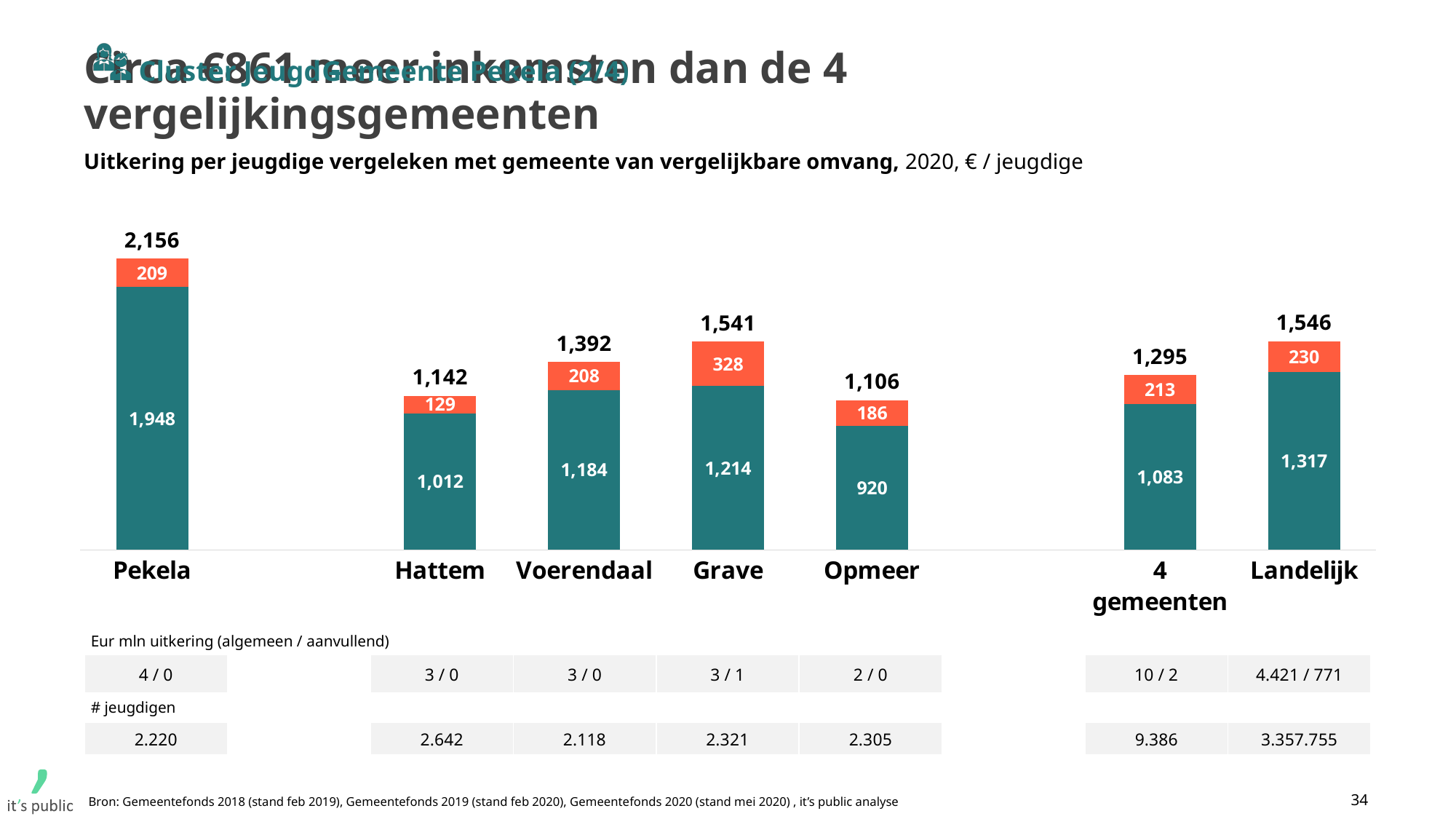
What is the total value printed above the bar for Landelijk? 1,546 Which category has the smallest orange (upper) segment? Hattem Which category has the highest total value? Pekela What is the value of the teal (lower) segment for Opmeer? 920 What is the difference between the printed totals for Pekela and 4 gemeenten? 861 What is the value of the teal (lower) segment for Hattem? 1,012 Which has a larger total value, Grave or Voerendaal? Grave What kind of chart is shown on the slide? Stacked bar chart How many categories (bars) are shown in the chart? 7 What is the total value printed above the bar for Pekela? 2,156 Which category has the lowest total value? Opmeer What is the value of the orange (upper) segment for Grave? 328